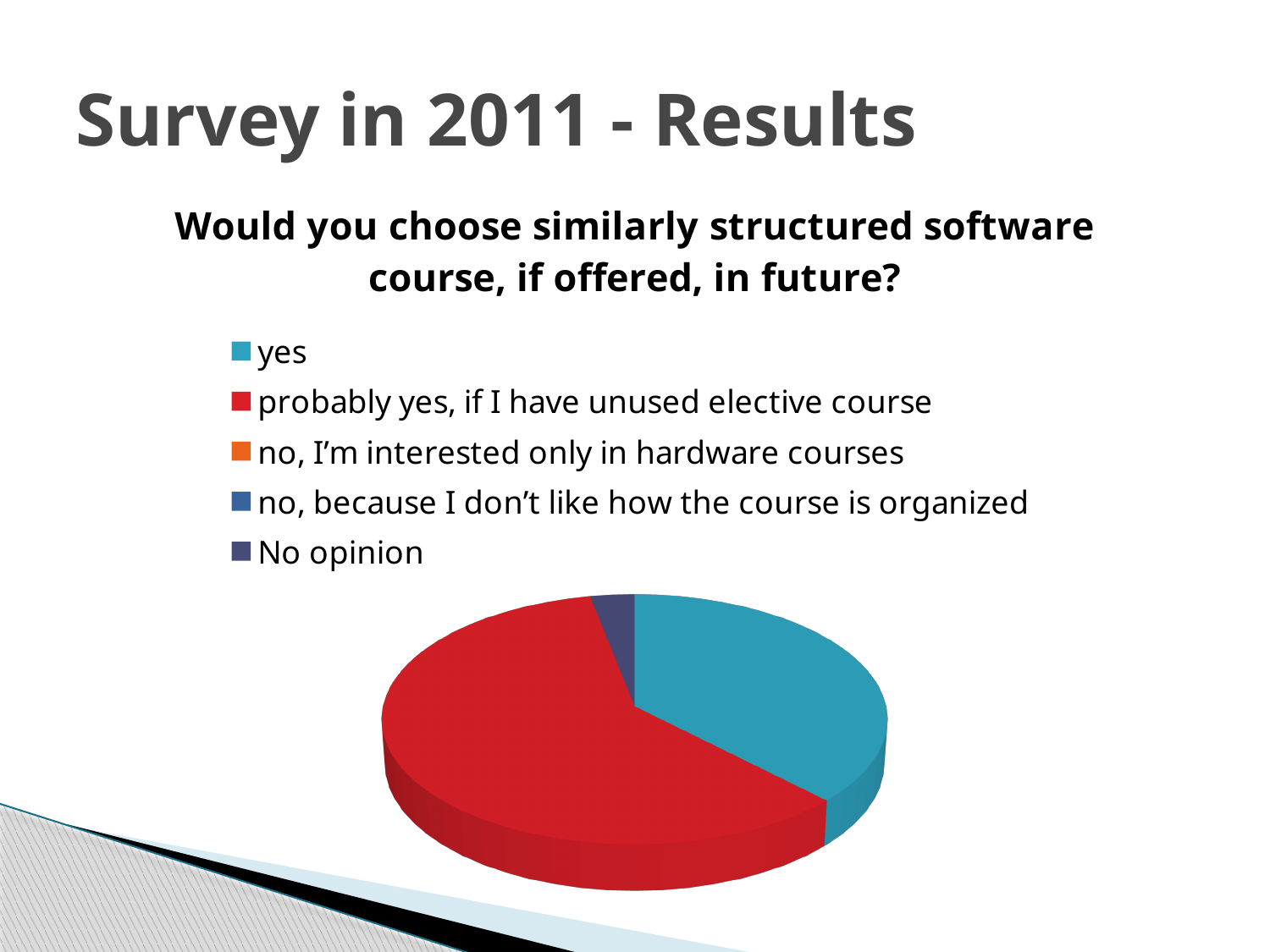
How many entries does the chart's legend list? 5 Which slice is larger: "yes" or "No opinion"? yes What kind of chart is shown on the slide? pie chart Which legend entry is shown in red? probably yes, if I have unused elective course Which response has the largest slice of the pie? probably yes, if I have unused elective course What colour is the slice for "yes"? teal (blue-green) What is the title of the chart? Would you choose similarly structured software course, if offered, in future? Which slice is larger: "yes" or "probably yes, if I have unused elective course"? probably yes, if I have unused elective course Which slice is larger: "No opinion" or "probably yes, if I have unused elective course"? probably yes, if I have unused elective course